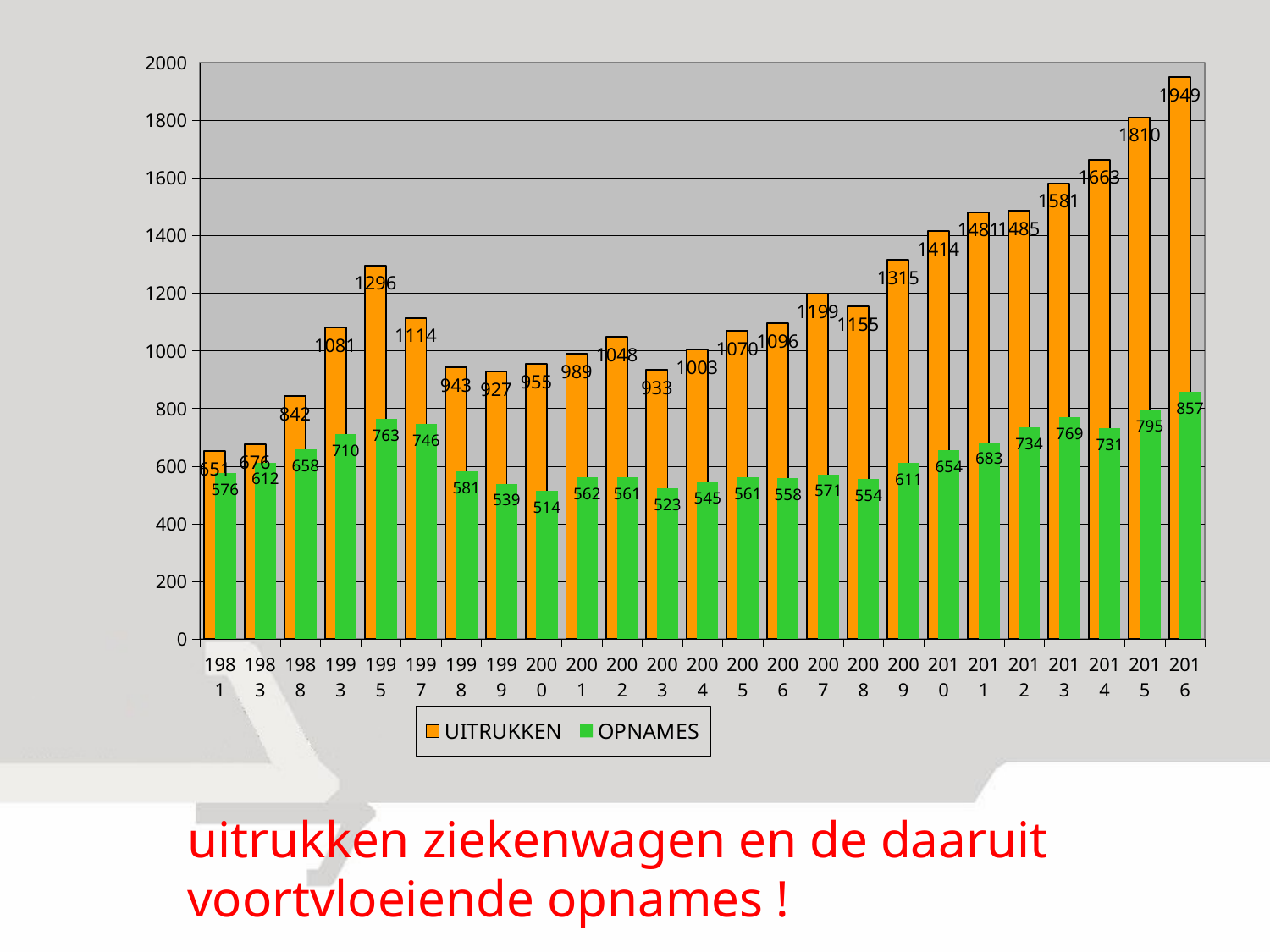
Do the UITRUKKEN values generally rise or fall from 2003 to 2016? rise Which year has the highest UITRUKKEN value? 2016 What is the difference between the UITRUKKEN and OPNAMES values for 2016? 1092 What colour are the OPNAMES bars? green What is the UITRUKKEN value for 1995? 1296 Which year has the lowest OPNAMES value? 2000 How many years are shown on the x axis? 25 What is the OPNAMES value for 2000? 514 How many series does the legend list? 2 What is the UITRUKKEN value for 2016? 1949 Which is larger, the UITRUKKEN value for 1995 or the UITRUKKEN value for 1997? 1995 What type of chart is shown on the slide? bar chart